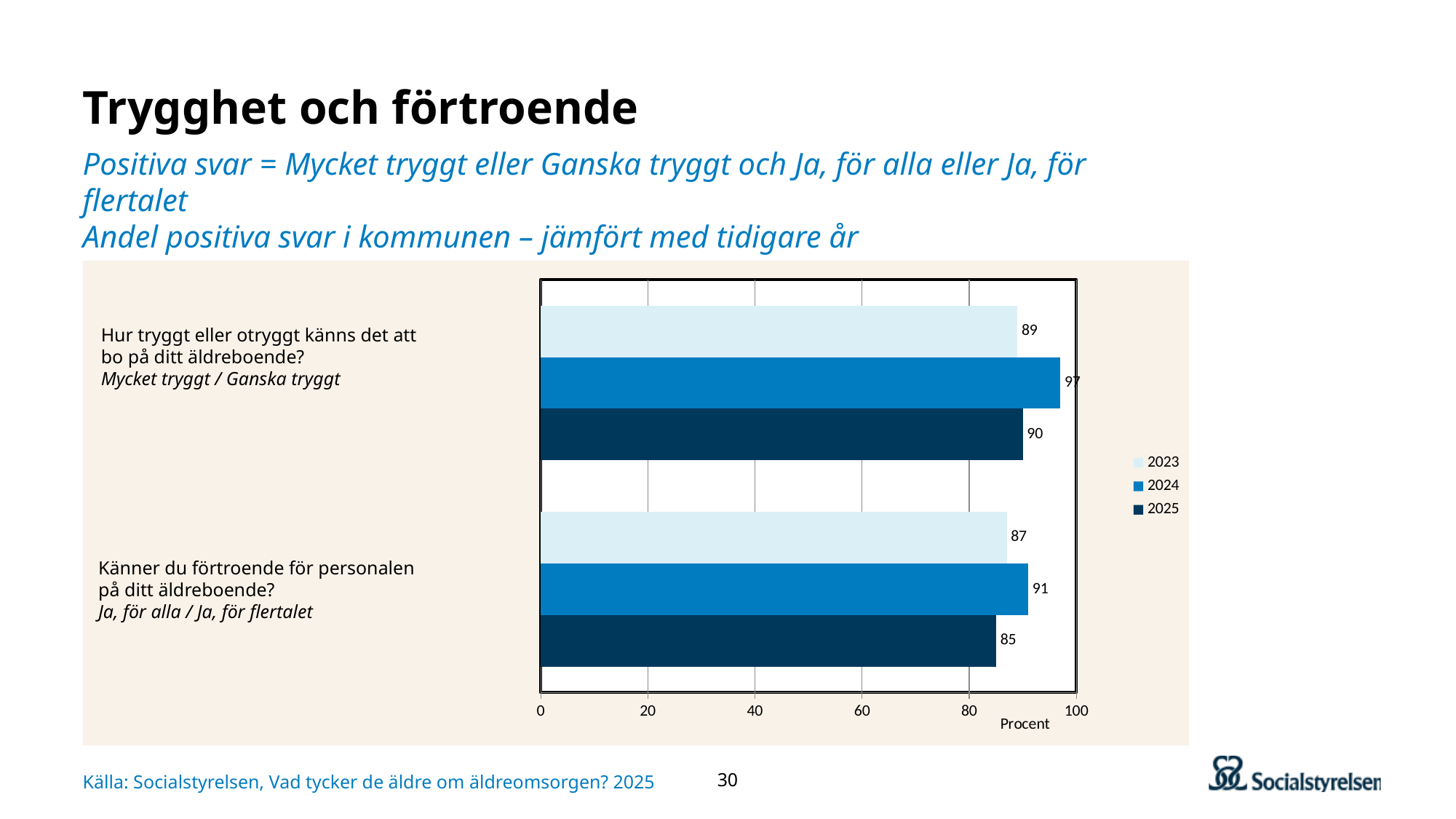
What is the 2025 value for "Känner du förtroende för personalen på ditt äldreboende?"? 85 How many question categories are shown on the chart? 2 Which year has the lowest value for "Hur tryggt eller otryggt känns det att bo på ditt äldreboende?"? 2023 What is the 2023 value for "Hur tryggt eller otryggt känns det att bo på ditt äldreboende?"? 89 How many series does the legend list? 3 Which year has the highest value for "Känner du förtroende för personalen på ditt äldreboende?"? 2024 What is the 2024 value for "Hur tryggt eller otryggt känns det att bo på ditt äldreboende?"? 97 Is the 2024 value for "Känner du förtroende för personalen på ditt äldreboende?" greater or less than 80? greater What is the difference between the 2024 and 2025 values for "Hur tryggt eller otryggt känns det att bo på ditt äldreboende?"? 7 What kind of chart is shown on the slide? Bar chart Which is larger: the 2023 value for "Känner du förtroende för personalen på ditt äldreboende?" or the 2025 value for the same question? 2023 What is the label on the horizontal axis of the chart? Procent